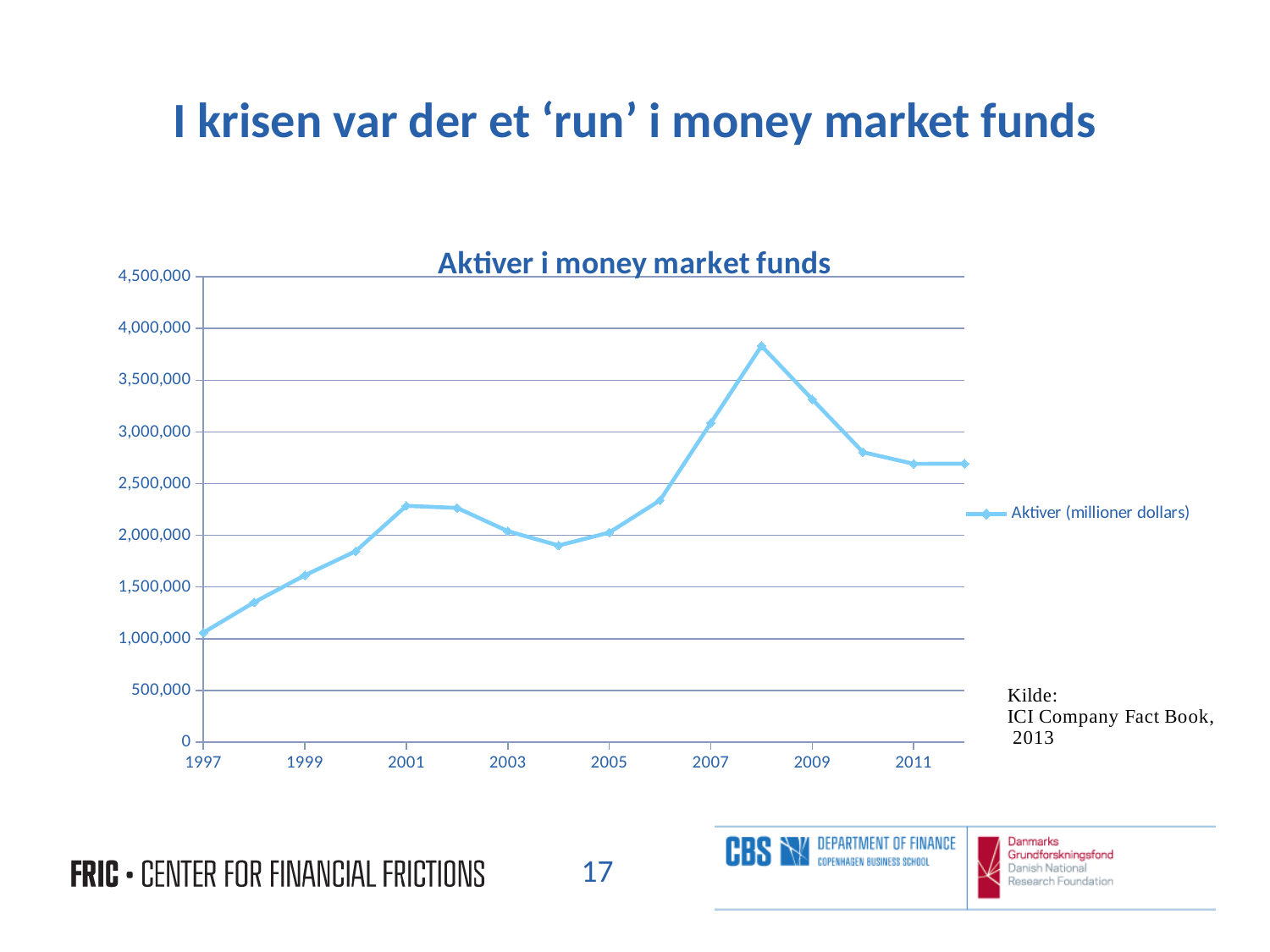
What kind of chart is shown on the slide? line chart Is the value for 2009 greater or less than 3,000,000? greater What is the name of the series shown in the legend? Aktiver (millioner dollars) What is the title of the chart? Aktiver i money market funds In which year does the line have its lowest value? 1997 How many series does the legend list? 1 Is the value for 2004 greater or less than 2,000,000? less Which year has the larger value, 2007 or 2009? 2009 Is the value for 2008 greater or less than 3,500,000? greater In which year does the line reach its highest value? 2008 Does the line rise or fall between 2008 and 2010? fall